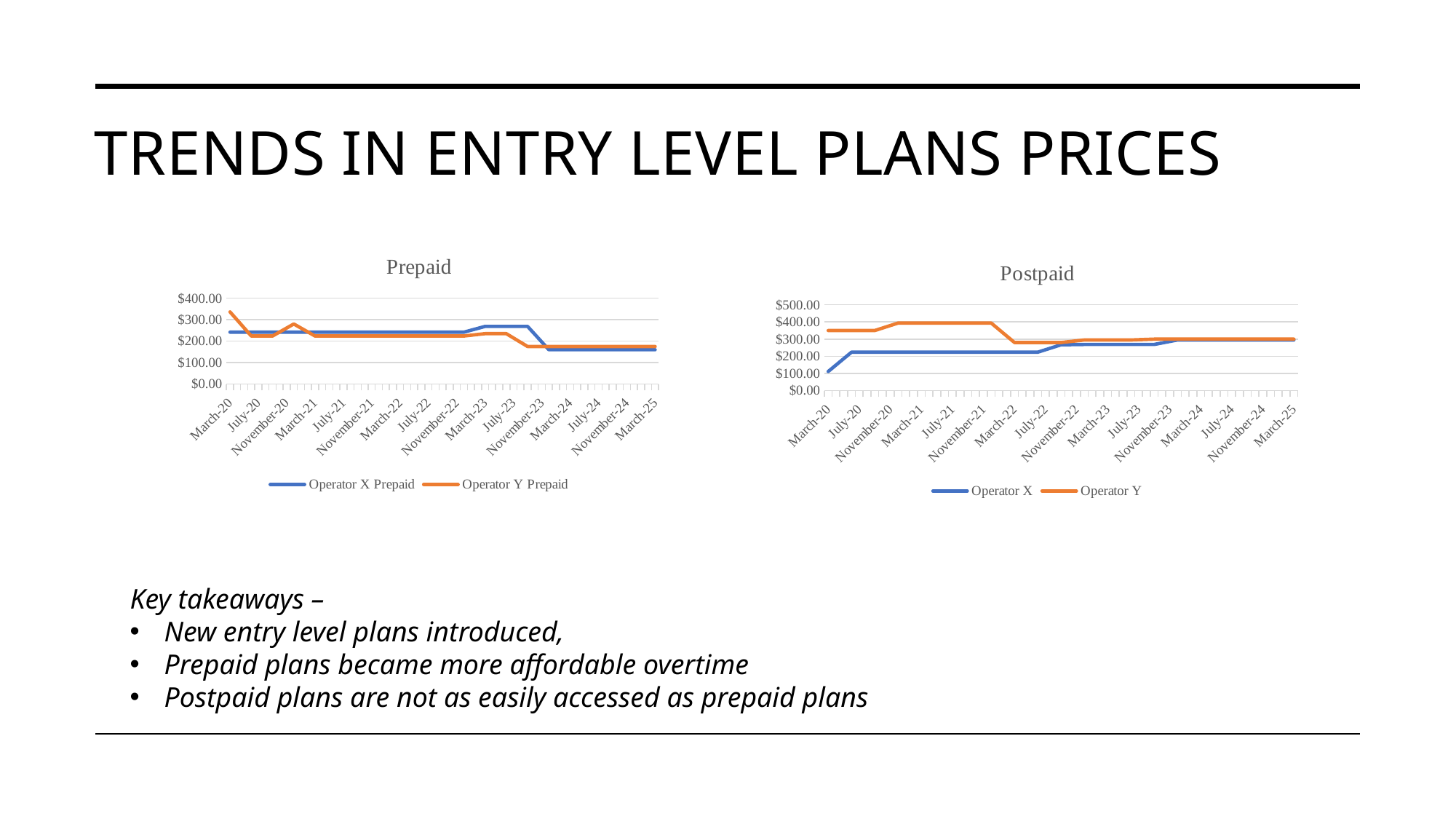
How many series does the legend of the Postpaid chart list? 2 What are the two legend entries in the Prepaid chart? Operator X Prepaid and Operator Y Prepaid What kind of chart is the Prepaid chart? line chart In the Postpaid chart, is the value for Operator X at March-20 greater or less than $200.00? less In the Prepaid chart, does the Operator X Prepaid line rise or fall overall from March-20 to March-25? fall In the Postpaid chart, is the value for Operator Y at March-20 greater or less than $300.00? greater In the Prepaid chart, is the value for Operator Y Prepaid at March-20 greater or less than $300.00? greater What is the title of the chart on the right side of the slide? Postpaid In the Prepaid chart, which series has the higher value at March-20, Operator X Prepaid or Operator Y Prepaid? Operator Y Prepaid In the Postpaid chart, which series has the higher value at March-21, Operator X or Operator Y? Operator Y In the Postpaid chart, does the Operator X line rise or fall overall from March-20 to March-25? rise